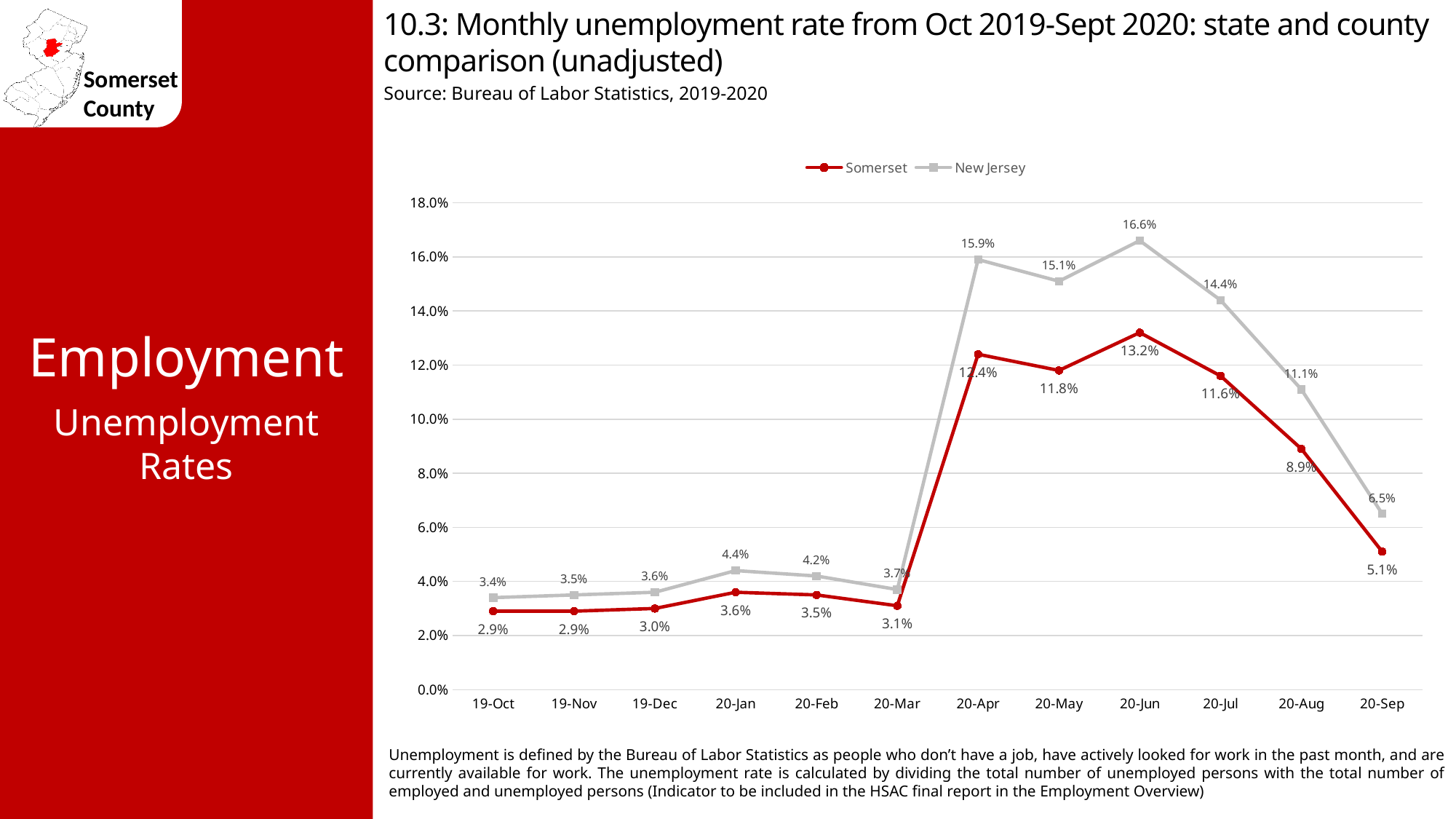
In which months was the Somerset unemployment rate at its lowest value? 19-Oct and 19-Nov Which series had the higher unemployment rate in 20-Aug, Somerset or New Jersey? New Jersey What was the Somerset unemployment rate in 20-Sep? 5.1% From 20-Jun to 20-Sep, does the Somerset unemployment rate rise or fall? Fall How many months are plotted on the x axis? 12 In which month did the New Jersey unemployment rate reach its highest value? 20-Jun What kind of chart is shown on the slide? Line chart What is the difference between the New Jersey and Somerset unemployment rates in 20-Jun? 3.4% What was the New Jersey unemployment rate in 20-Apr? 15.9% What was the Somerset unemployment rate in 20-Jun? 13.2% Is the Somerset unemployment rate in 20-Apr greater or less than 12.0%? greater How many series does the legend list? 2